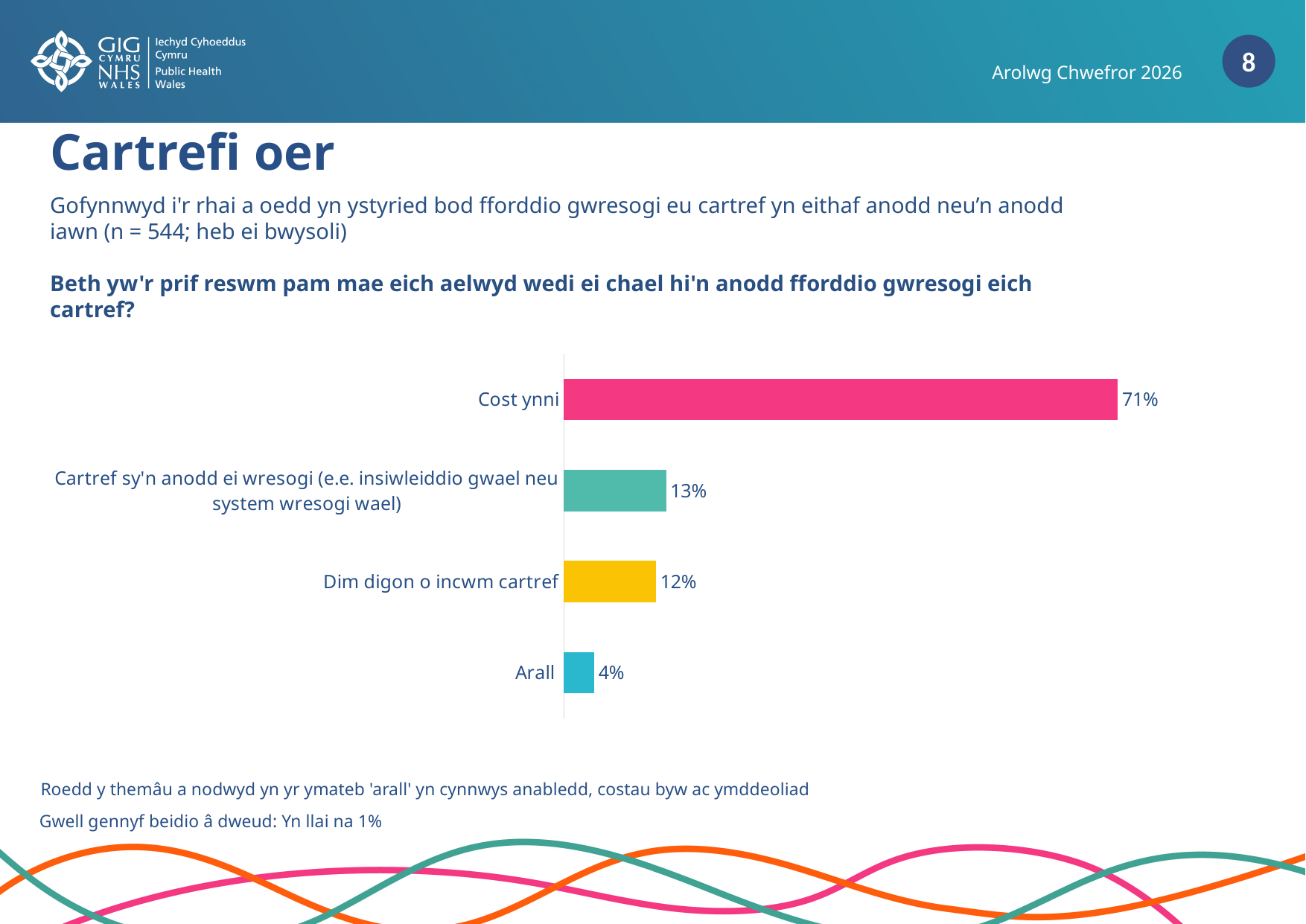
Which category has the lowest value? Arall What percentage is shown for 'Cartref sy'n anodd ei wresogi (e.e. insiwleiddio gwael neu system wresogi wael)'? 13% Which is larger: the value for 'Cost ynni' or the value for 'Arall'? Cost ynni What percentage is shown for 'Dim digon o incwm cartref'? 12% Which category has the highest value? Cost ynni What is the difference between the values for 'Cartref sy'n anodd ei wresogi' and 'Arall'? 9% How many categories are shown in the chart? 4 What colour is the bar for 'Cost ynni'? Pink What kind of chart is shown on the slide? Bar chart What percentage is shown for 'Cost ynni'? 71% What is the difference between the values for 'Cost ynni' and 'Dim digon o incwm cartref'? 59% What percentage is shown for 'Arall'? 4%